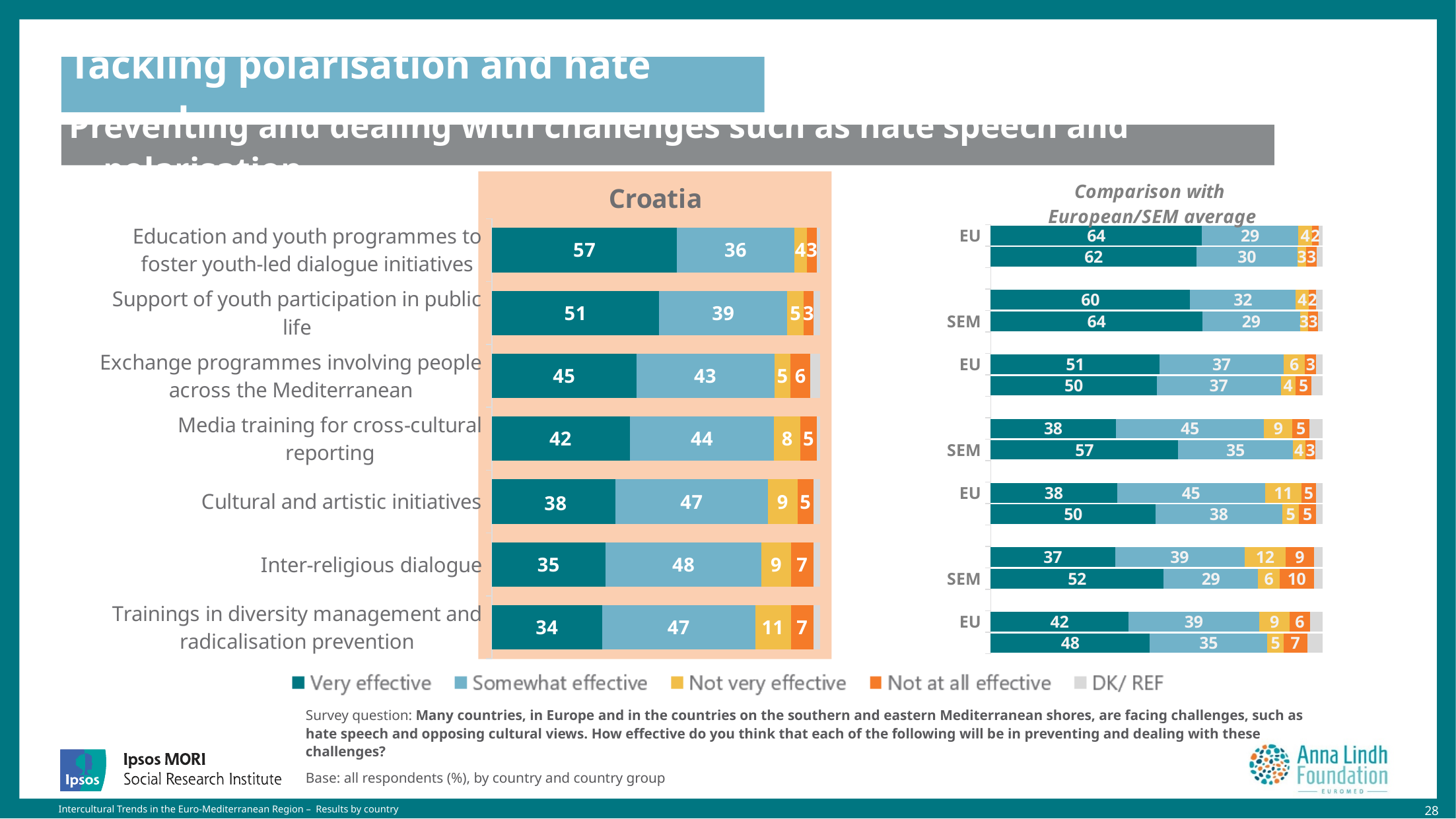
In the Croatia chart, which category has the highest 'Very effective' value? Education and youth programmes to foster youth-led dialogue initiatives In the 'Comparison with European/SEM average' chart, what is the EU 'Very effective' value for the first item (Education and youth programmes)? 64 How many series does the legend list? 5 In the Croatia chart, what is the 'Somewhat effective' value for 'Inter-religious dialogue'? 48 In the Croatia chart, which is larger: the 'Very effective' value for 'Cultural and artistic initiatives' or for 'Exchange programmes involving people across the Mediterranean'? Exchange programmes involving people across the Mediterranean How many categories are shown in the Croatia chart? 7 In the Croatia chart, what is the 'Not very effective' value for 'Trainings in diversity management and radicalisation prevention'? 11 Which legend entry is shown in dark teal? Very effective What type of chart is the Croatia chart? Stacked bar chart In the Croatia chart, what percentage rated 'Education and youth programmes to foster youth-led dialogue initiatives' as very effective? 57 In the Croatia chart, which category has the lowest 'Very effective' value? Trainings in diversity management and radicalisation prevention In the Croatia chart, what is the difference between the 'Very effective' values for 'Support of youth participation in public life' and 'Media training for cross-cultural reporting'? 9